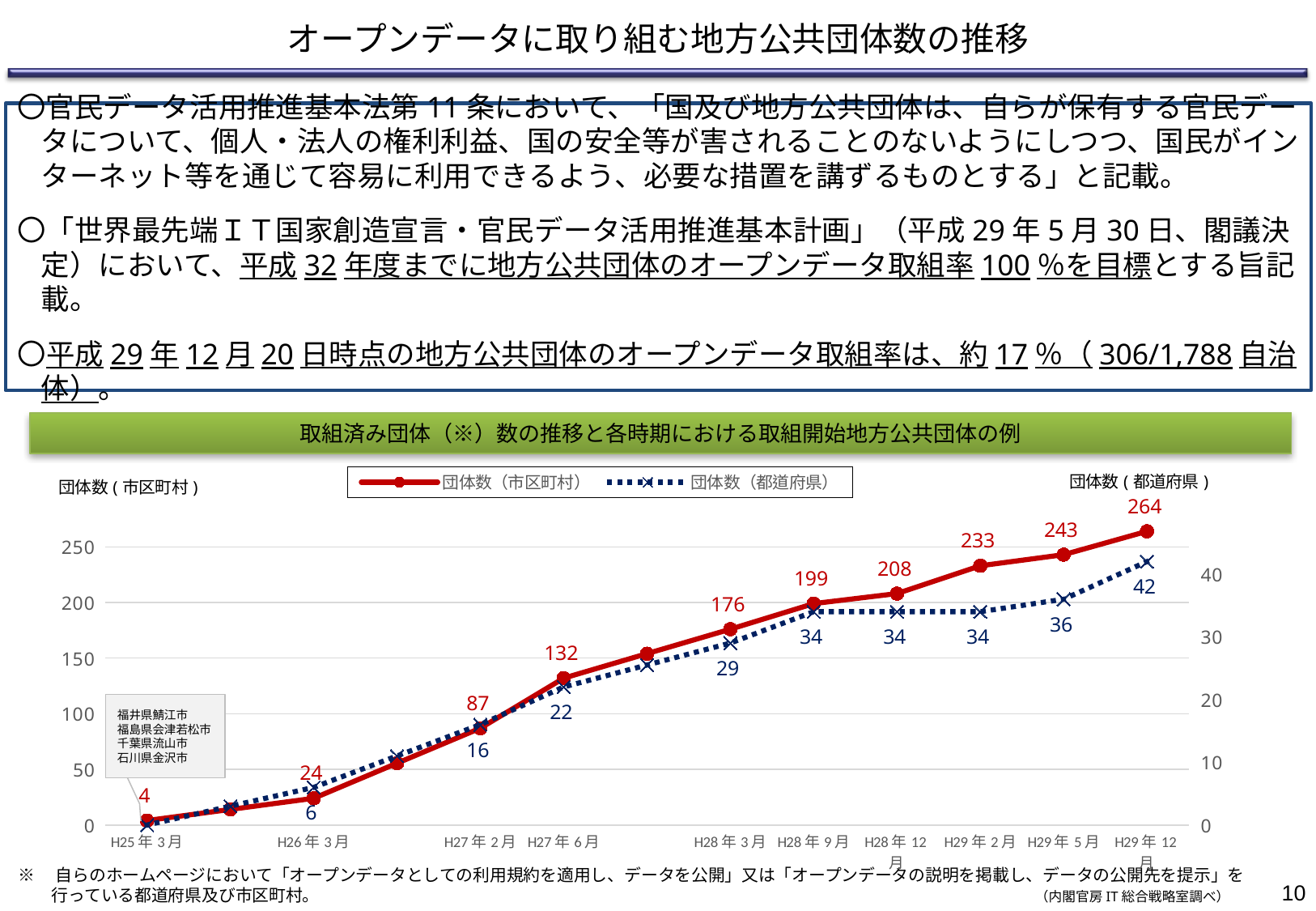
How many series does the legend list? 2 What is the value of 団体数（都道府県） at H29年5月? 36 What is the value of 団体数（市区町村） at H27年6月? 132 Which is larger for 団体数（市区町村）: the value at H28年9月 or at H28年12月? H28年12月 What kind of chart is shown on the slide? Line chart What is the lowest labeled value of 団体数（市区町村）? 4 Is the value of 団体数（市区町村） at H28年3月 greater or less than 150? greater Does 団体数（市区町村） rise or fall from H25年3月 to H29年12月? Rise At which x-axis label does 団体数（市区町村） reach its highest labeled value? H29年12月 What is the difference between 団体数（市区町村） at H29年12月 and at H29年5月? 21 What is the value of 団体数（都道府県） at H28年3月? 29 What is the value of 団体数（市区町村） at H29年12月? 264